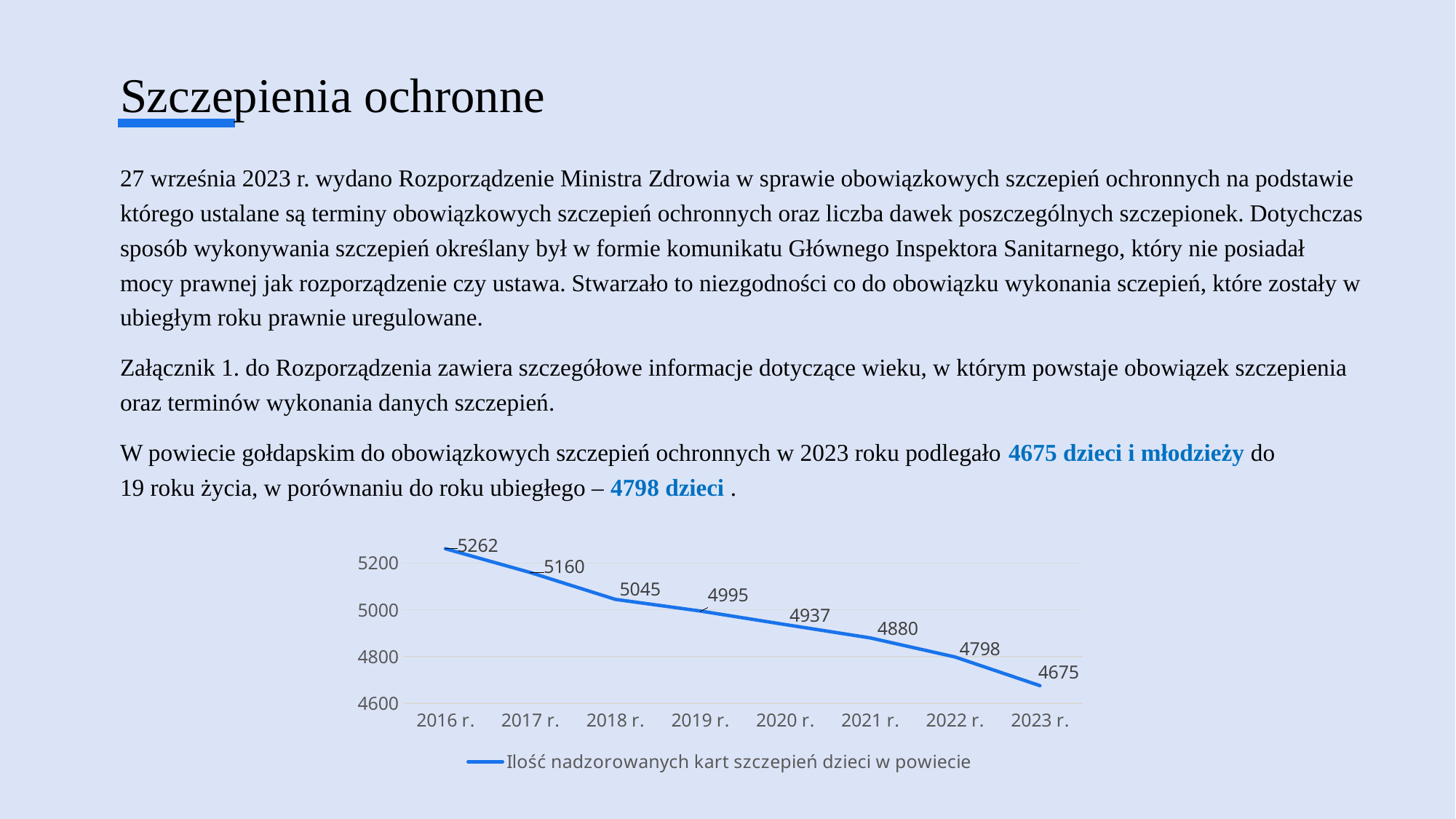
What is the difference between the values for 2016 r. and 2023 r.? 587 What kind of chart is shown on the slide? line chart Which year has the highest value? 2016 r. What is the value for 2019 r.? 4995 What is the value for 2016 r.? 5262 Which year has the lowest value? 2023 r. What is the difference between the values for 2022 r. and 2023 r.? 123 What is the value for 2023 r.? 4675 Which is larger, the value for 2018 r. or the value for 2021 r.? 2018 r. How many years are plotted on the chart? 8 Is the value for 2020 r. greater or less than 5000? less Do the values rise or fall from 2016 r. to 2023 r.? fall